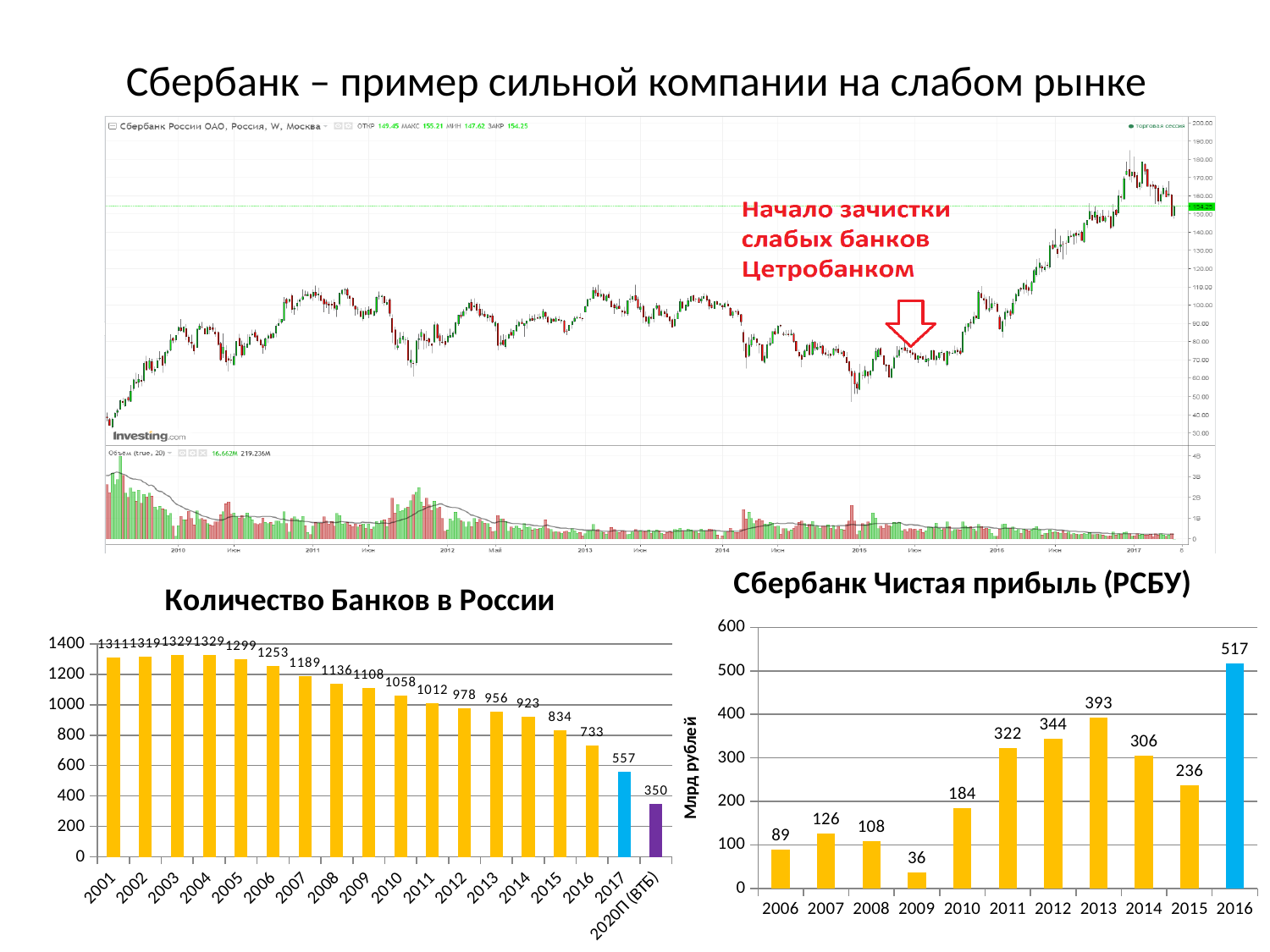
In the chart 'Количество Банков в России', what is the value for 2016? 733 In the chart 'Сбербанк Чистая прибыль (РСБУ)', what is the difference between the values for 2013 and 2014? 87 In the chart 'Количество Банков в России', what is the difference between the values for 2015 and 2017? 277 What kind of chart is 'Количество Банков в России'? bar chart In the chart 'Сбербанк Чистая прибыль (РСБУ)', which year has the highest value? 2016 In the chart 'Сбербанк Чистая прибыль (РСБУ)', what is the y-axis title? Млрд рублей In the chart 'Количество Банков в России', what is the value for 2020П (ВТБ)? 350 In the chart 'Сбербанк Чистая прибыль (РСБУ)', which is larger, the value for 2011 or the value for 2015? 2011 In the chart 'Количество Банков в России', do the values generally rise or fall from 2006 to 2017? fall In the chart 'Сбербанк Чистая прибыль (РСБУ)', how many years are shown on the x axis? 11 In the chart 'Сбербанк Чистая прибыль (РСБУ)', which year has the lowest value? 2009 In the chart 'Сбербанк Чистая прибыль (РСБУ)', what is the value for 2016? 517